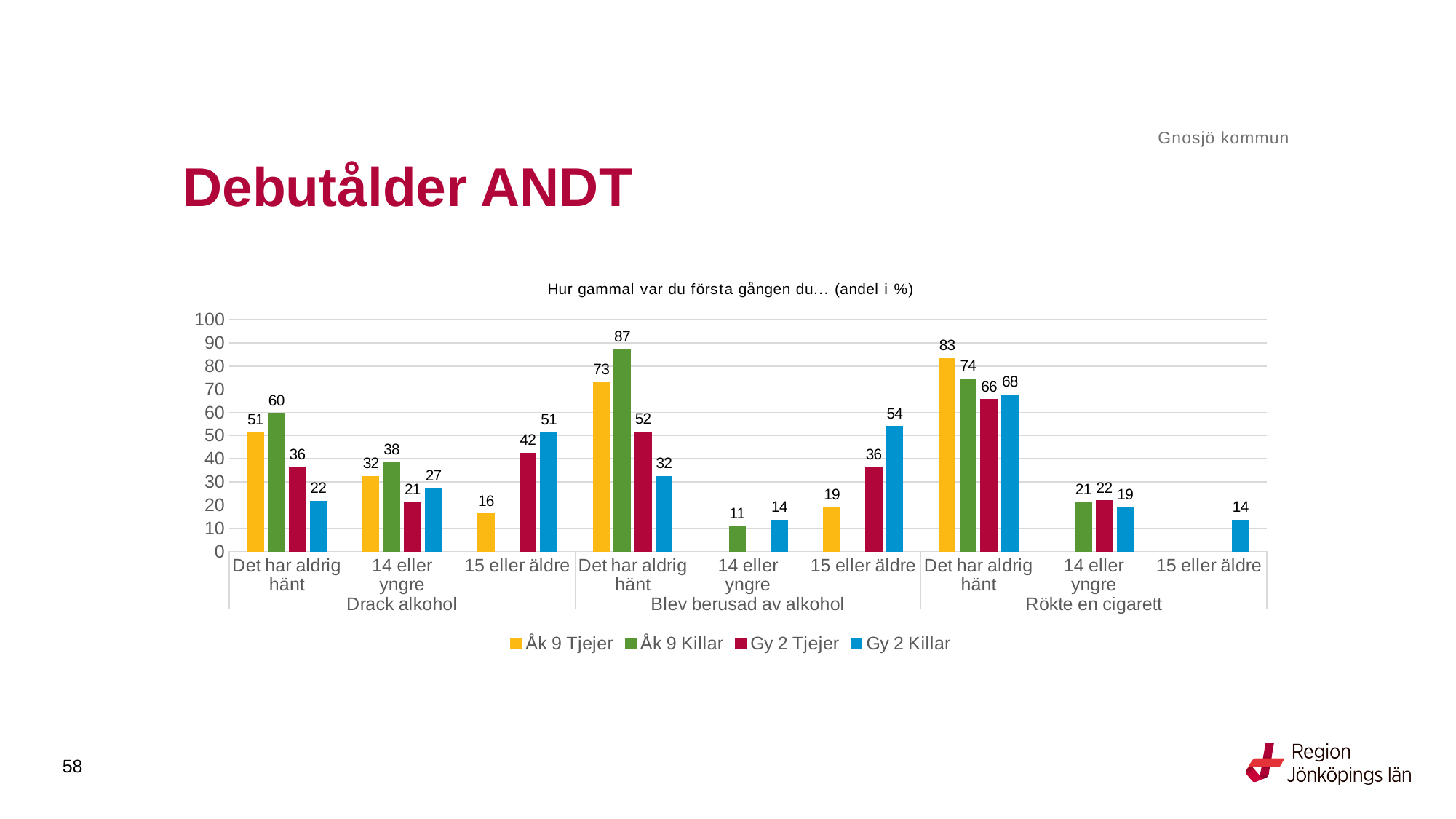
What is the value for Åk 9 Killar for 'Det har aldrig hänt' under 'Blev berusad av alkohol'? 87 What is the difference between Åk 9 Killar and Åk 9 Tjejer for 'Det har aldrig hänt' under 'Blev berusad av alkohol'? 14 What is the value for Gy 2 Killar for '15 eller äldre' under 'Rökte en cigarett'? 14 Is the value for Åk 9 Tjejer for 'Det har aldrig hänt' under 'Rökte en cigarett' greater or less than 80? greater What is the title of the chart? Hur gammal var du första gången du… (andel i %) What is the value for Gy 2 Killar for '15 eller äldre' under 'Drack alkohol'? 51 How many series does the legend list? 4 Which is larger: Gy 2 Killar for '15 eller äldre' under 'Blev berusad av alkohol' or Gy 2 Tjejer for the same category? Gy 2 Killar What type of chart is shown on the slide? bar chart What is the value for Gy 2 Tjejer for 'Det har aldrig hänt' under 'Rökte en cigarett'? 66 Which series has the lowest value for 'Det har aldrig hänt' under 'Drack alkohol'? Gy 2 Killar Which series has the highest value for 'Det har aldrig hänt' under 'Rökte en cigarett'? Åk 9 Tjejer